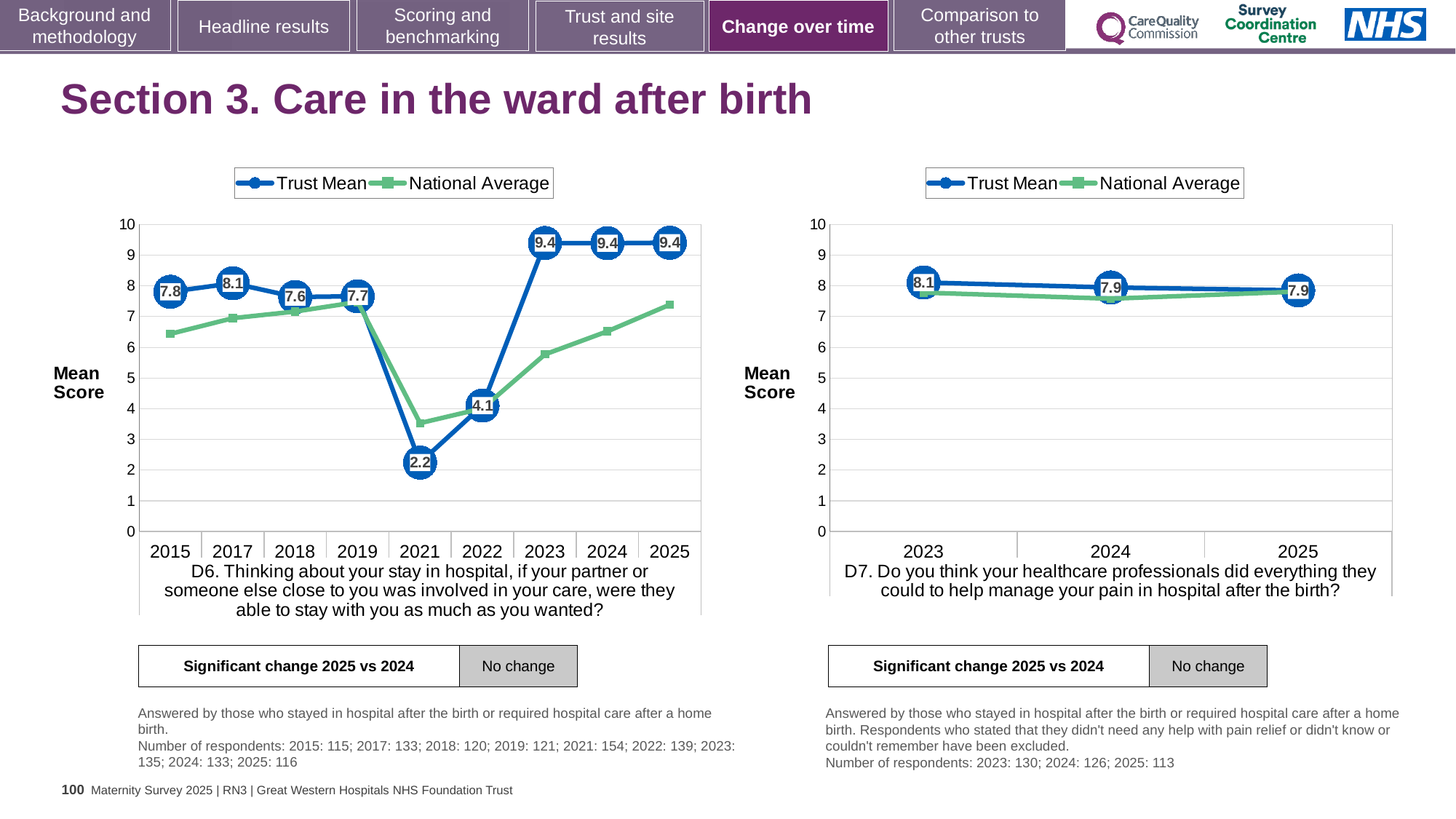
On the left chart (D6), what is the Trust Mean for 2017? 8.1 On the left chart (D6), how many years are shown on the x axis? 9 On the right chart (D7), what is the difference between the Trust Mean in 2023 and in 2025? 0.2 On the right chart (D7), what is the Trust Mean for 2023? 8.1 On the right chart (D7), how many series does the legend list? 2 On the left chart (D6), which year has the lowest Trust Mean? 2021 On the left chart (D6), is the National Average for 2015 greater or less than 7? less On the left chart (D6), what is the difference between the Trust Mean in 2022 and in 2021? 1.9 On the left chart (D6), what is the Trust Mean for 2025? 9.4 What type of chart is the right chart (D7)? Line chart On the left chart (D6), is the Trust Mean or the National Average higher in 2023? Trust Mean On the left chart (D6), what is the Trust Mean for 2021? 2.2